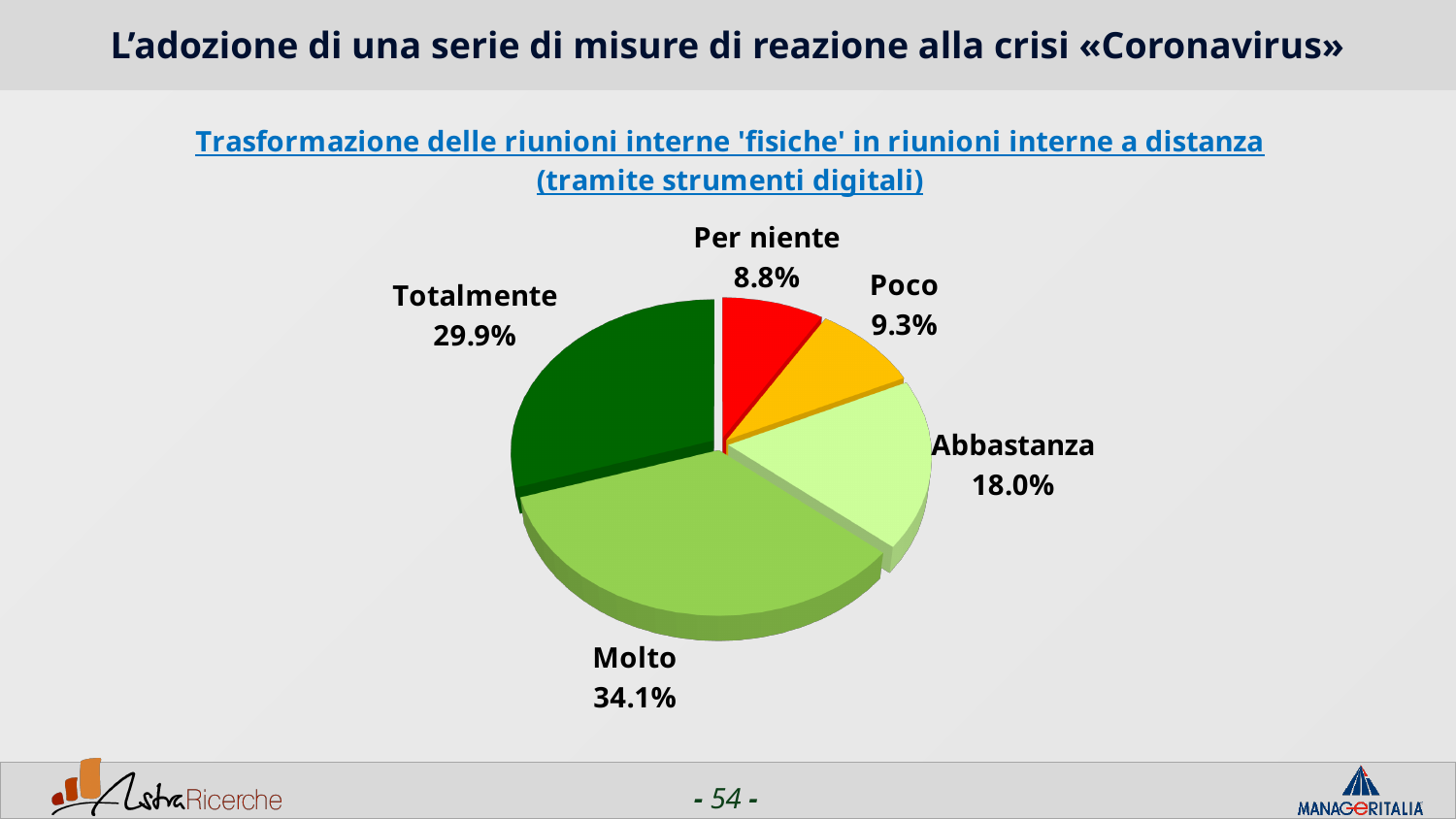
Which category has the largest share of the pie? Molto How many categories are shown in the pie chart? 5 What is the value for 'Totalmente'? 29.9% What colour is the 'Per niente' slice? Red What is the value for 'Per niente'? 8.8% What is the combined share of 'Totalmente' and 'Molto'? 64.0% What is the value for 'Molto'? 34.1% Which is larger, the value for 'Poco' or the value for 'Per niente'? Poco What is the difference between the values for 'Molto' and 'Totalmente'? 4.2% What type of chart is shown on the slide? Pie chart What is the value for 'Abbastanza'? 18.0% Which category has the smallest share of the pie? Per niente